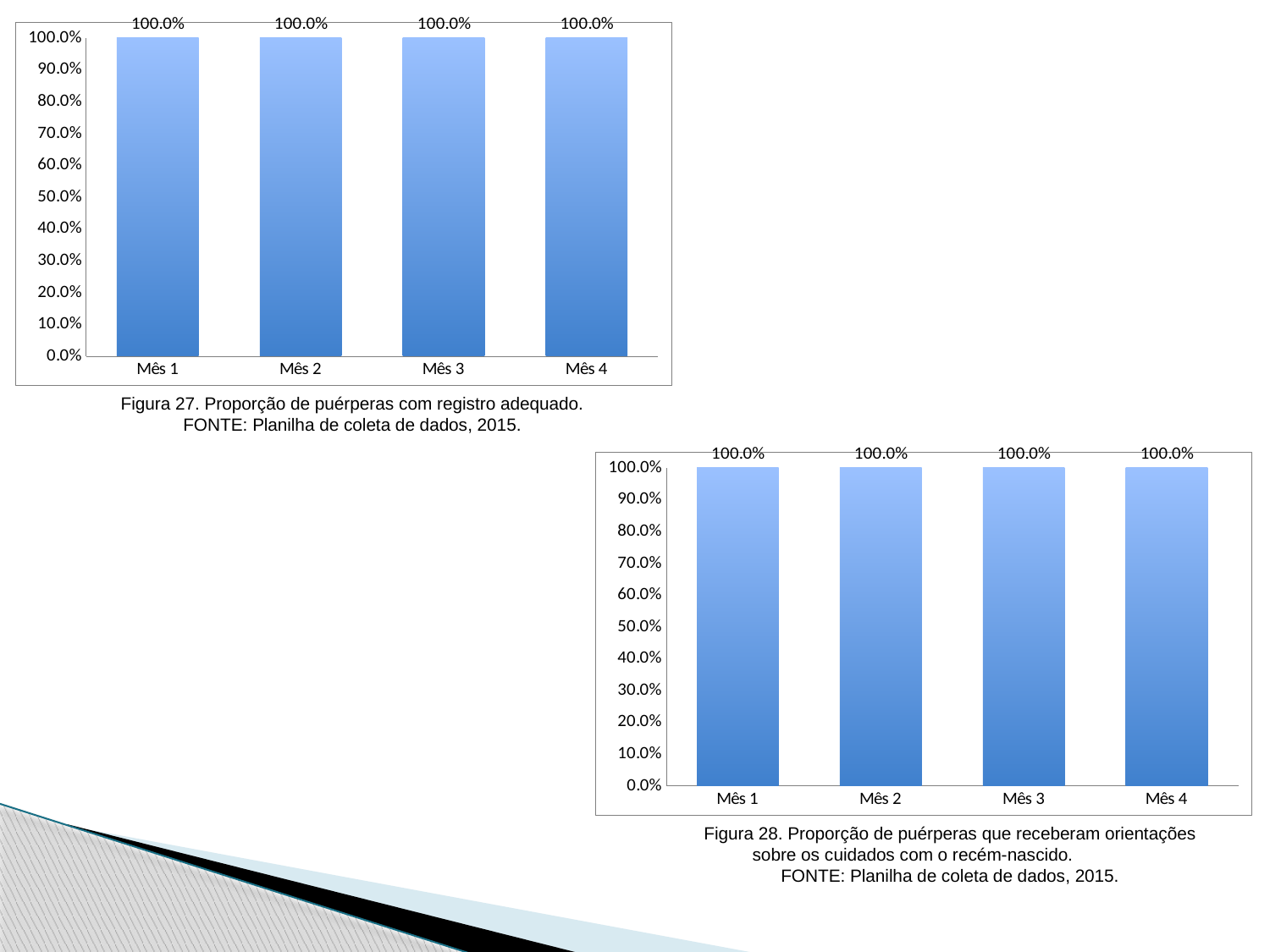
In the bottom-right chart (Figura 28), what is the value for Mês 2? 100.0% In the bottom-right chart (Figura 28), what is the value for Mês 3? 100.0% What kind of chart is the top-left chart (Figura 27)? Bar chart How many categories are shown on the x axis of the top-left chart (Figura 27)? 4 In the bottom-right chart (Figura 28), do the values rise, fall, or stay the same from Mês 1 to Mês 4? Stay the same How many bars are plotted in the bottom-right chart (Figura 28)? 4 In the top-left chart (Figura 27), what is the value for Mês 4? 100.0% In the top-left chart (Figura 27), is the value for Mês 2 greater or less than 50.0%? greater In the top-left chart (Figura 27), what is the value for Mês 1? 100.0% In the bottom-right chart (Figura 28), what is the difference between the values for Mês 2 and Mês 3? 0.0% In the top-left chart (Figura 27), what is the difference between the values for Mês 1 and Mês 4? 0.0% What is the caption title of the bottom-right chart? Figura 28. Proporção de puérperas que receberam orientações sobre os cuidados com o recém-nascido.